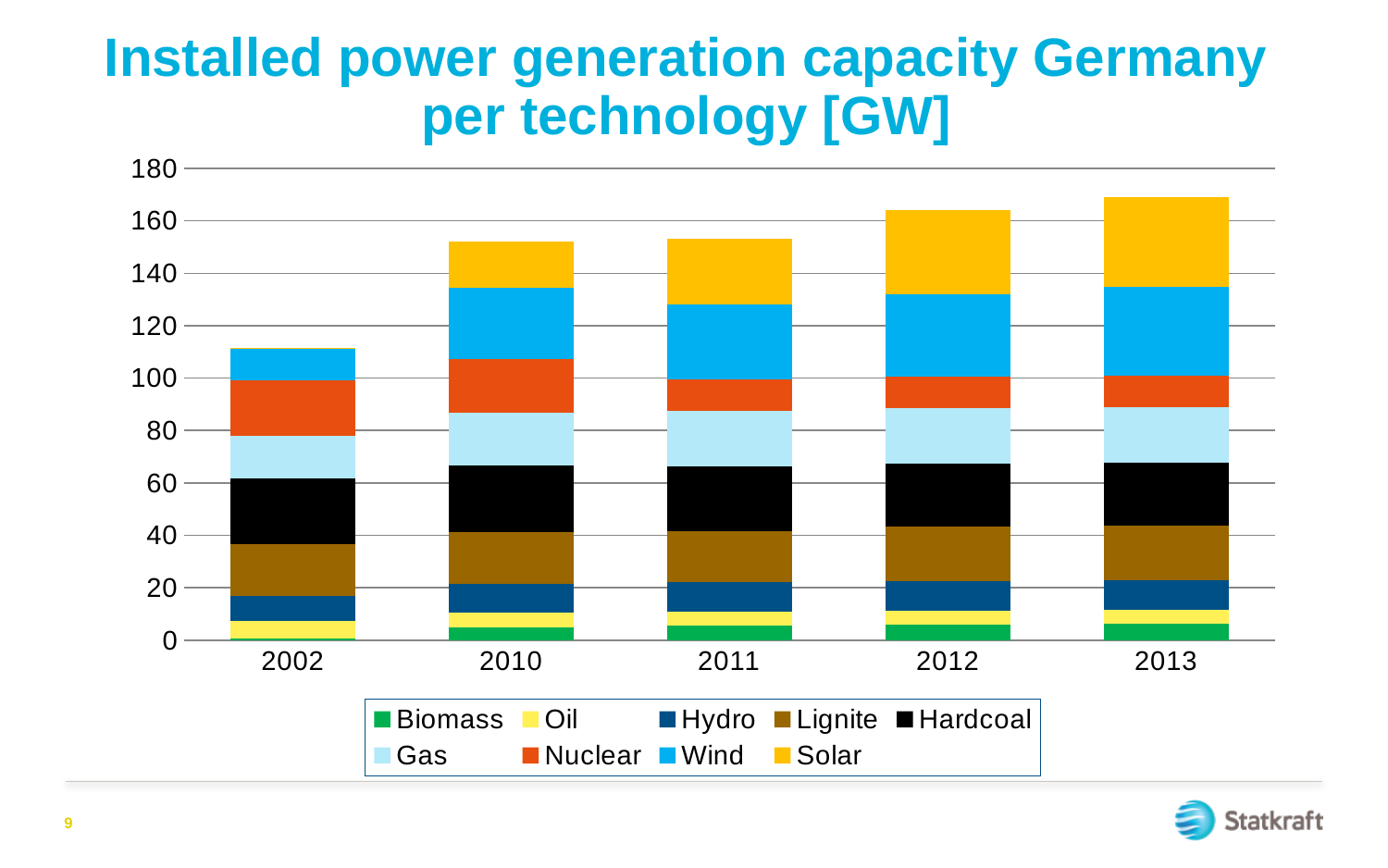
Does the total installed capacity generally rise or fall from 2002 to 2013? Rise How many series does the legend list? 9 How many years are shown on the x axis of the chart? 5 What is the title of the chart? Installed power generation capacity Germany per technology [GW] Is the total installed capacity for 2002 greater or less than 120? less What kind of chart is shown on the slide? Stacked bar chart Is the total installed capacity for 2010 greater or less than 160? less Is the total installed capacity for 2002 greater or less than 100? greater Which year has the lowest total installed capacity? 2002 Which year has the larger total installed capacity, 2002 or 2012? 2012 Which year has the highest total installed capacity? 2013